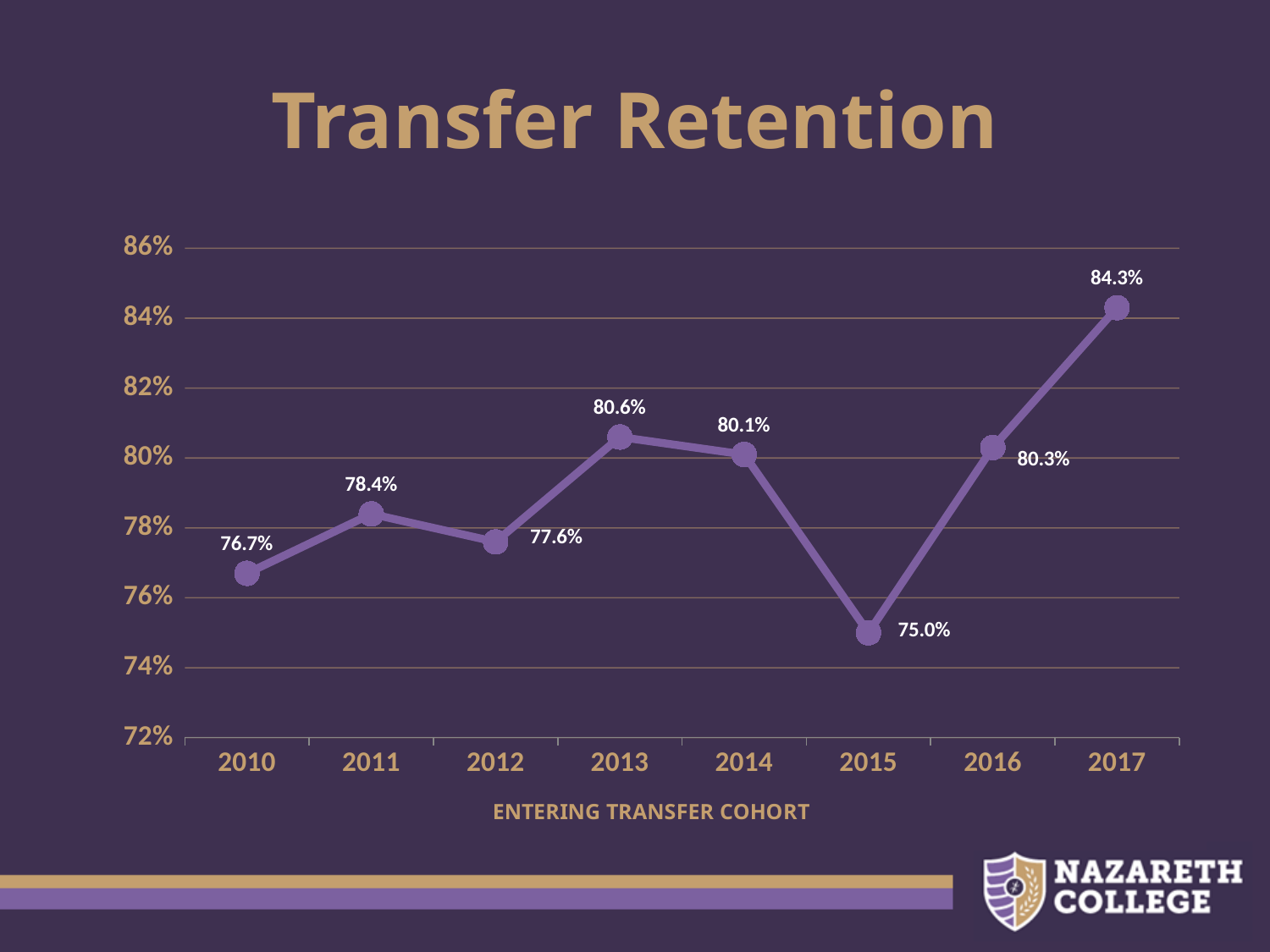
What is the difference in retention between the 2011 and 2010 cohorts? 1.7% Which cohort has higher retention, 2012 or 2014? 2014 What is the transfer retention value for the 2010 cohort? 76.7% What is the x-axis label of the chart? ENTERING TRANSFER COHORT What is the difference in retention between the 2017 and 2015 cohorts? 9.3% How many entering transfer cohorts are plotted on the chart? 8 What is the transfer retention value for the 2016 cohort? 80.3% What kind of chart is shown on the slide? line chart Which entering transfer cohort has the lowest retention? 2015 What is the transfer retention value for the 2013 cohort? 80.6% Which entering transfer cohort has the highest retention? 2017 Is the retention value for the 2015 cohort greater or less than 76%? less